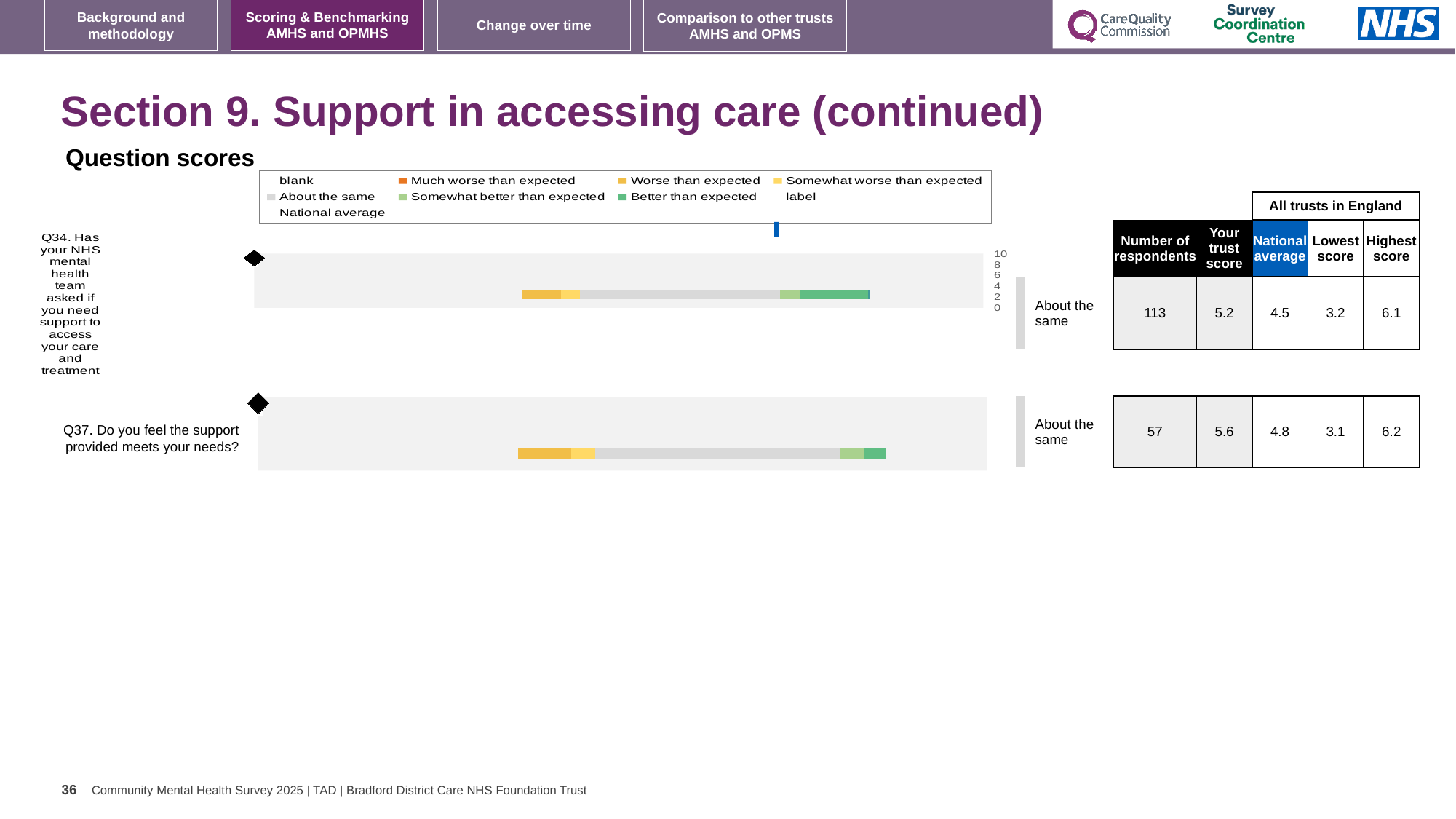
What colour does the legend use for 'Better than expected'? Green By how much does the trust score for Q34 exceed the national average for Q34? 0.7 What is the difference between the highest and lowest scores for Q37? 3.1 How many respondents are shown for Q34 in the table next to the chart? 113 What is the highest score among all trusts in England for Q37? 6.2 What is the lowest score among all trusts in England for Q34? 3.2 What kind of chart is used to show the question scores for Q34 and Q37? Bar chart What is the 'Your trust score' value for Q37? 5.6 What benchmark category label is shown next to the Q34 bar? About the same How many questions are plotted in the question scores chart? 2 Which question has the higher 'Your trust score', Q34 or Q37? Q37 What is the national average score for Q34? 4.5